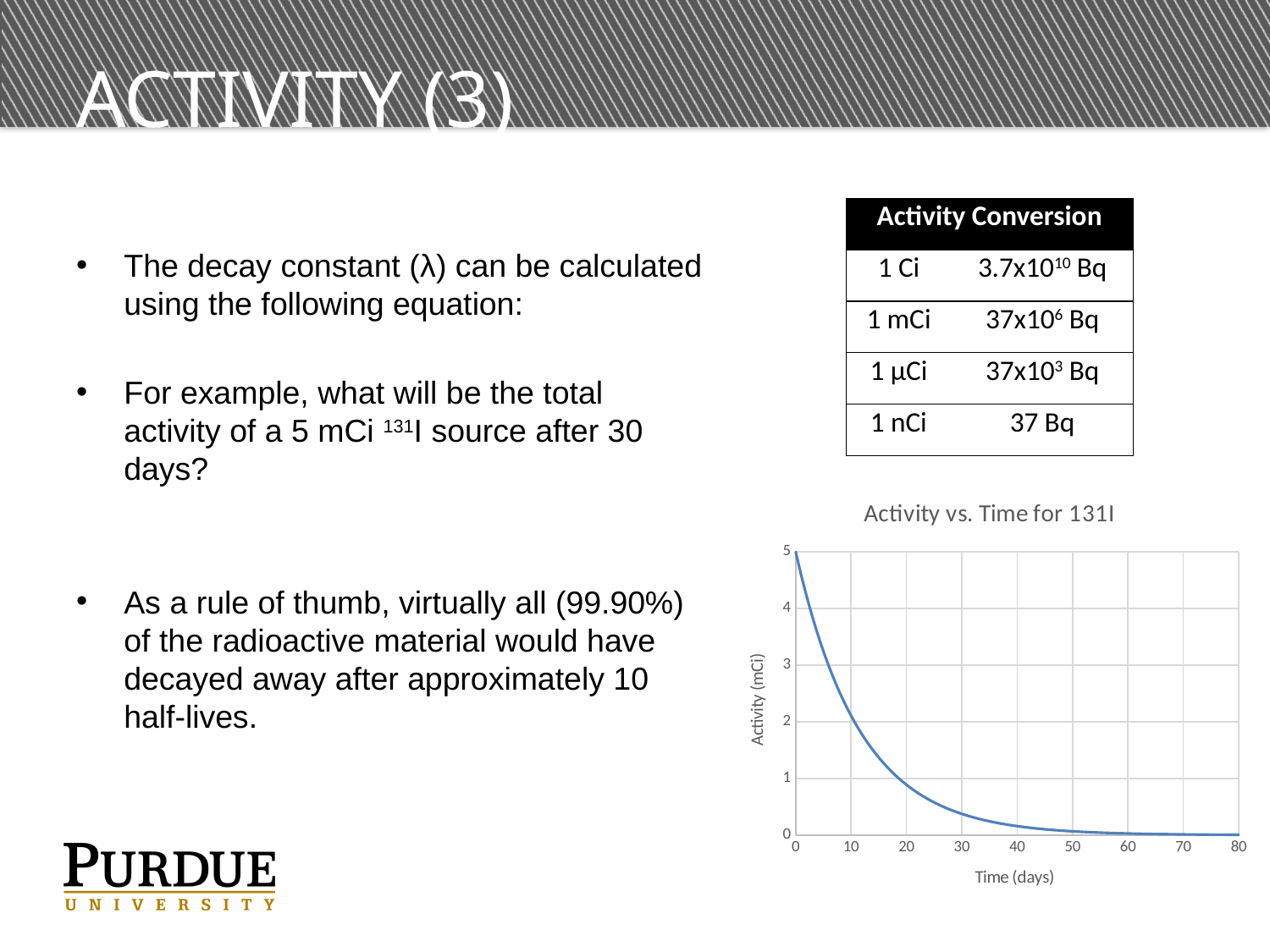
Is the activity at 30 days greater or less than 1 mCi? less Does the activity rise or fall as time increases along the x axis? fall Is the activity at 40 days greater or less than 1 mCi? less Is the activity at 5 days greater or less than 2 mCi? greater At what time (days) is the activity highest on the chart? 0 Which is larger, the activity at 10 days or the activity at 30 days? 10 days What is the label of the y axis of the chart? Activity (mCi) What is the title of the chart on the slide? Activity vs. Time for 131I What kind of chart is shown on the slide? line chart What is the activity in mCi at time 0 days on the chart? 5